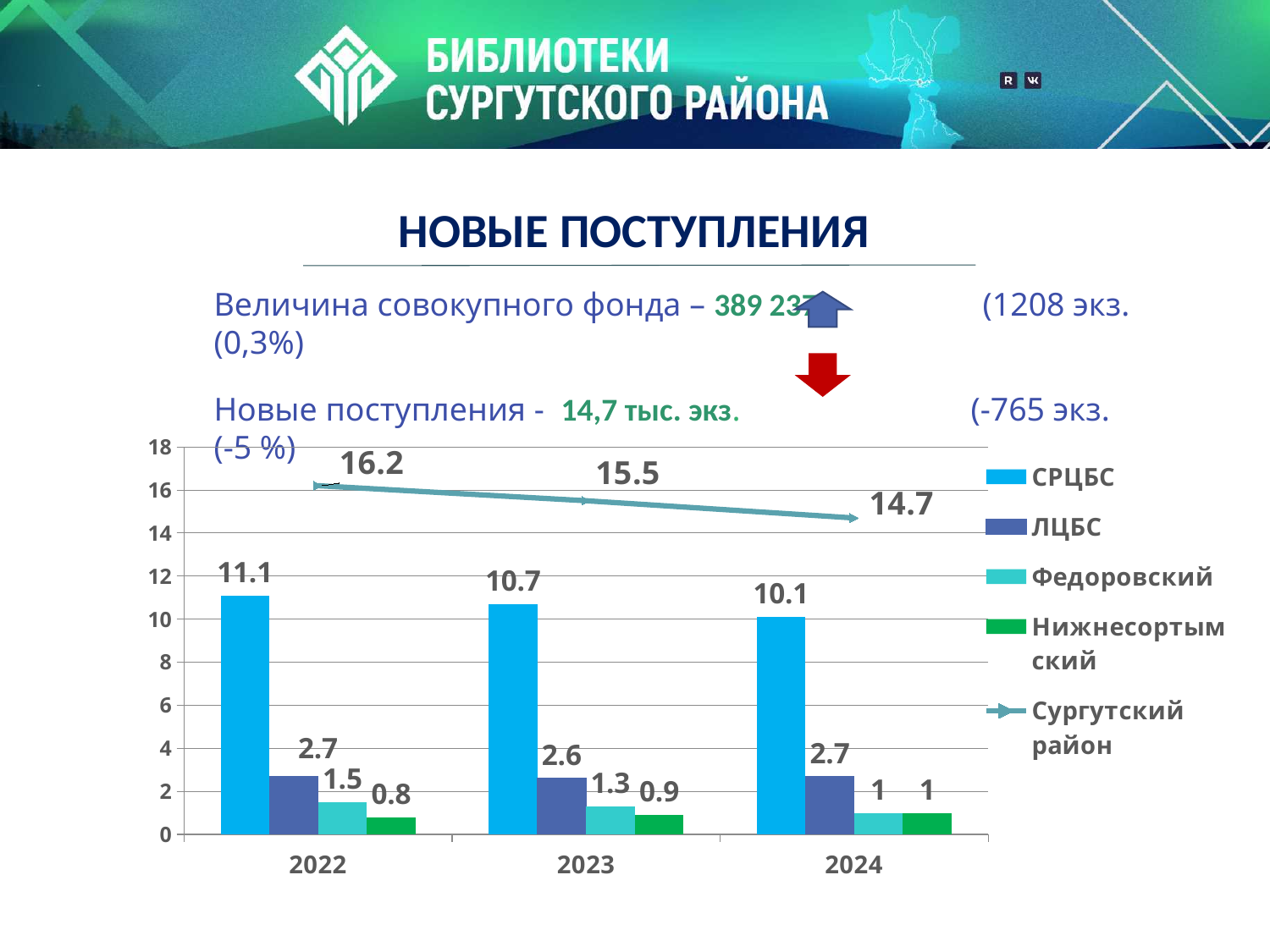
What is the value for Нижнесортымский in 2022? 0.8 How many years are shown on the x axis? 3 Which is larger: the value for ЛЦБС in 2023 or in 2024? 2024 Which series has the lowest value in 2023? Нижнесортымский What is the value for СРЦБС in 2022? 11.1 What is the value for Сургутский район in 2024? 14.7 What is the difference between the Сургутский район values for 2022 and 2024? 1.5 Does the Сургутский район line rise or fall from 2022 to 2024? falls How many series does the legend list? 5 Which year has the highest value for СРЦБС? 2022 Which series is drawn as a line rather than bars? Сургутский район What is the value for Федоровский in 2023? 1.3